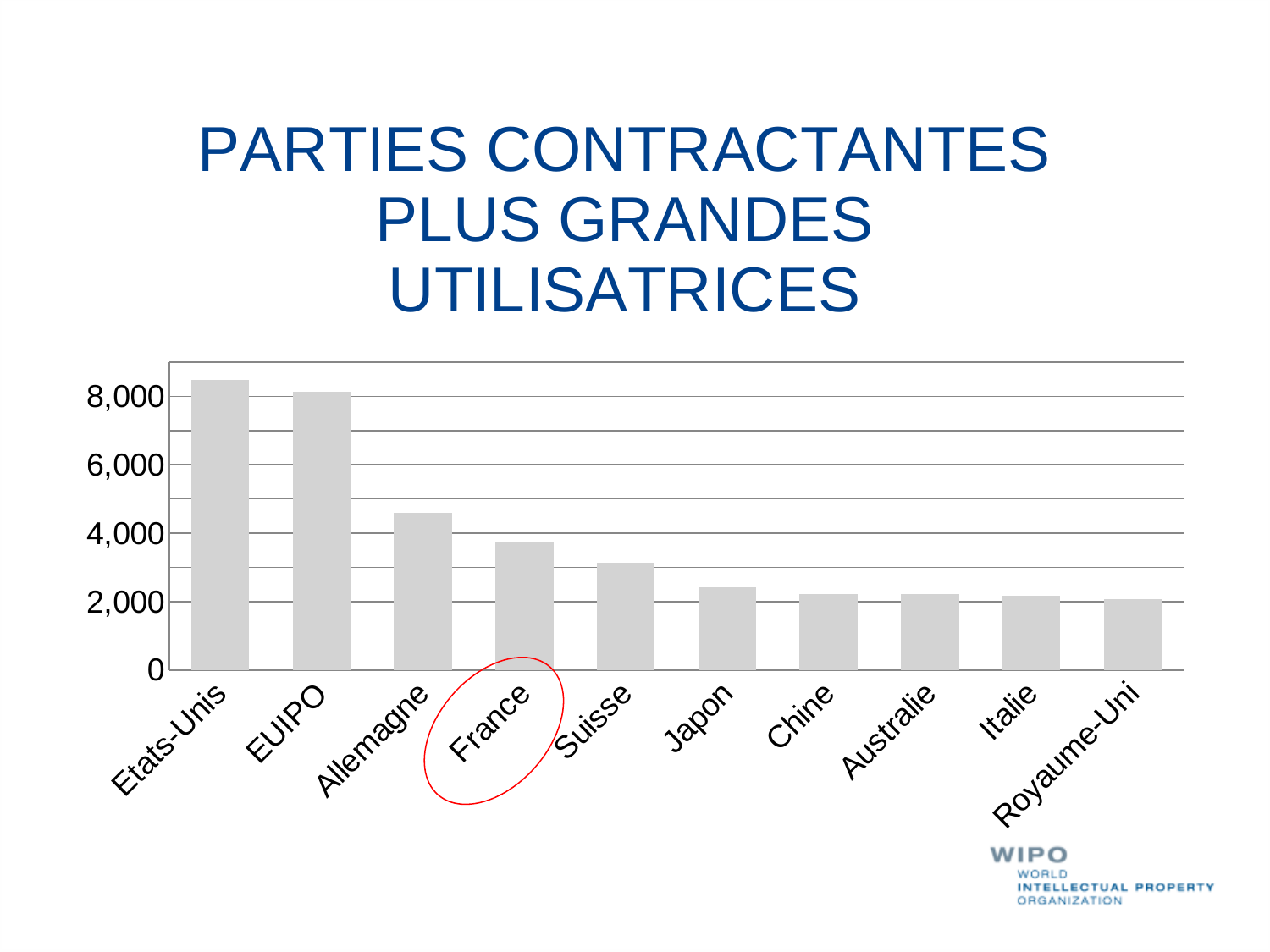
Do the bar values rise or fall from left to right along the x axis? fall Which category label on the x axis is circled in red? France Is the value for Etats-Unis greater or less than 8,000? greater Which has a larger value, Allemagne or France? Allemagne How many categories are shown on the x axis of the chart? 10 Which category has the highest bar in the chart? Etats-Unis Is the value for Japon greater or less than 2,000? greater Is the value for France greater or less than 4,000? less What kind of chart is shown on the slide? bar chart Which has a larger value, Etats-Unis or EUIPO? Etats-Unis